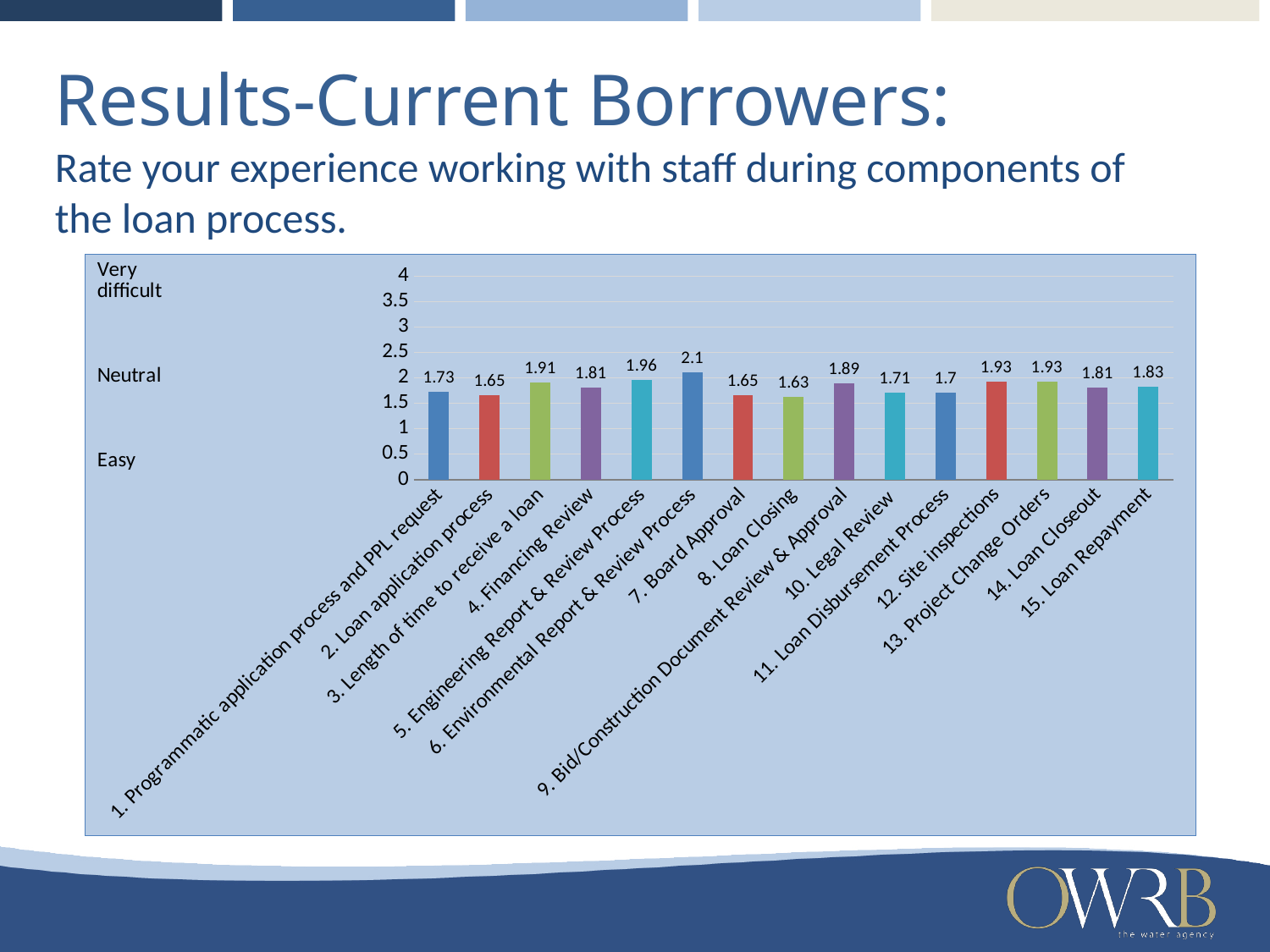
How many categories are shown on the x axis? 15 What label appears on the left side of the chart at the top of the scale? Very difficult What is the value for 1. Programmatic application process and PPL request? 1.73 What is the difference between the values for 7. Board Approval and 8. Loan Closing? 0.02 What is the value for 15. Loan Repayment? 1.83 Which category has the highest value? 6. Environmental Report & Review Process What is the value for 7. Board Approval? 1.65 What kind of chart is shown on the slide? bar chart Which category has the lowest value? 8. Loan Closing What is the value for 8. Loan Closing? 1.63 Which is larger, the value for 3. Length of time to receive a loan or the value for 4. Financing Review? 3. Length of time to receive a loan Is the value for 5. Engineering Report & Review Process greater or less than 2? less